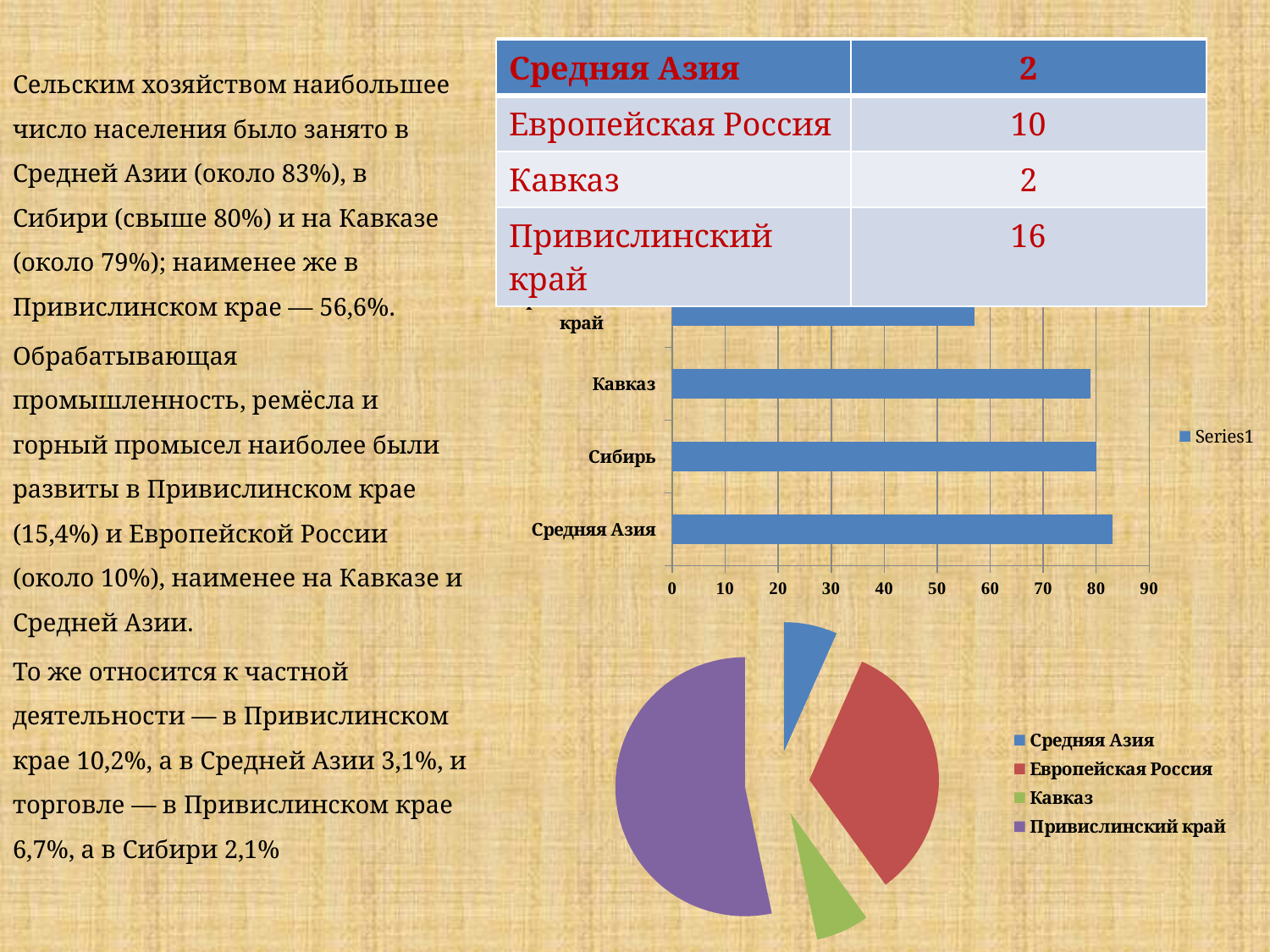
In the bar chart, is the value for Средняя Азия greater or less than 80? greater In the pie chart, which slice is larger, Европейская Россия or Кавказ? Европейская Россия In the pie chart, which category has the largest slice? Привислинский край In the bar chart, which category has the shortest bar? Привислинский край In the bar chart, how many categories are plotted? 4 In the bar chart, is the value for Кавказ greater or less than 70? greater What kind of chart is the lower chart on the right of the slide? pie chart What kind of chart is the upper chart on the right of the slide? bar chart In the bar chart, is the value for the top bar (Привислинский край) greater or less than 60? less In the bar chart, which is larger, the value for Кавказ or the value for Привислинский край? Кавказ In the pie chart, how many entries does the legend list? 4 In the bar chart, how many series does the legend list? 1